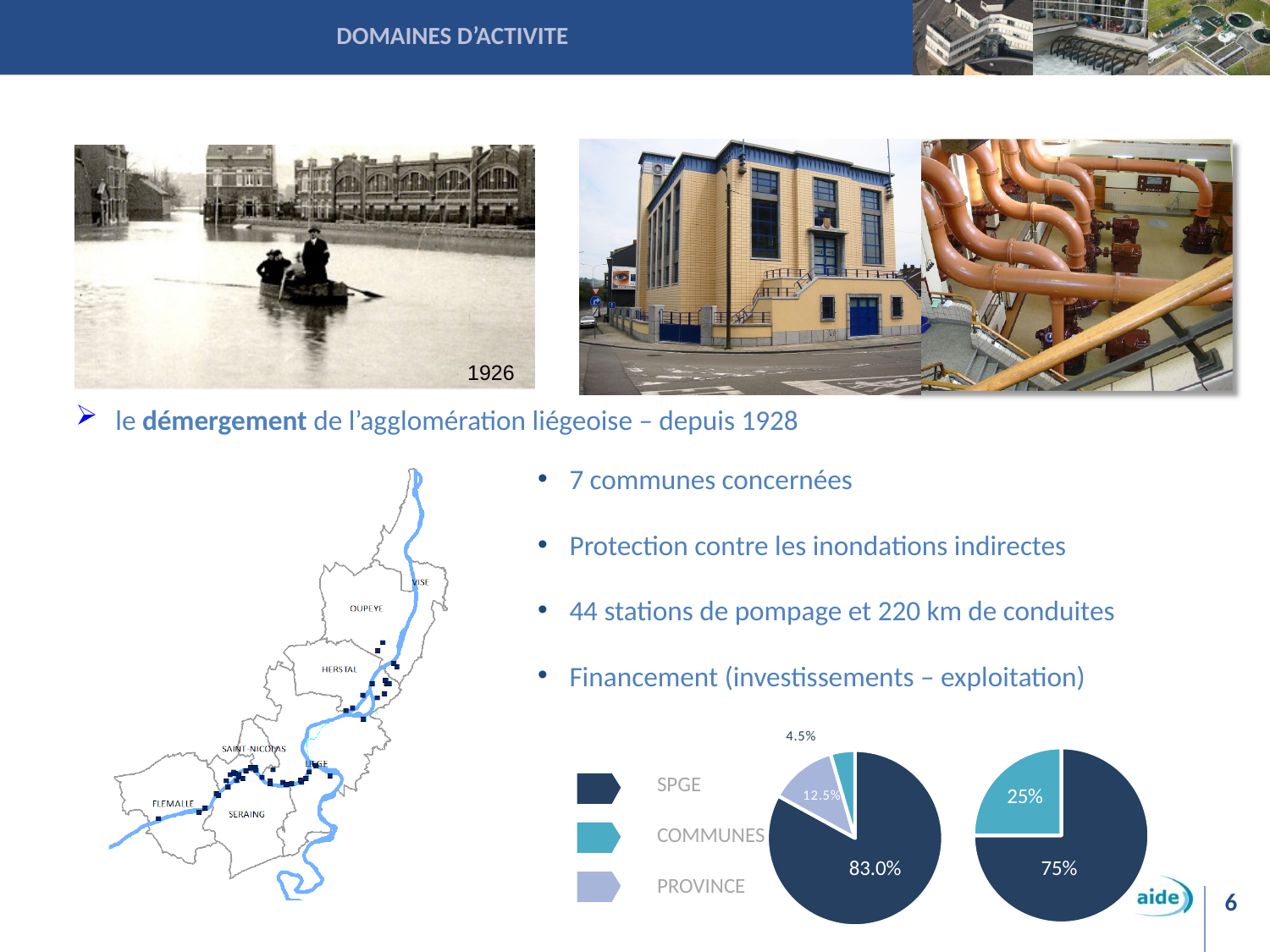
In the left pie chart, which category has the smallest slice? COMMUNES In the left pie chart, what share does PROVINCE have? 12.5% In the right pie chart, what share does SPGE have? 75% In the left pie chart, what share does COMMUNES have? 4.5% In the right pie chart, what share does COMMUNES have? 25% How many entries does the legend next to the pie charts list? 3 How many slices does the right pie chart have? 2 In the left pie chart, which category has the largest slice? SPGE In the left pie chart, what is the difference between the SPGE share and the PROVINCE share? 70.5% In the left pie chart, what share does SPGE have? 83.0% What kind of charts are shown at the bottom right of the slide? Pie charts In the right pie chart, what is the difference between the SPGE share and the COMMUNES share? 50%